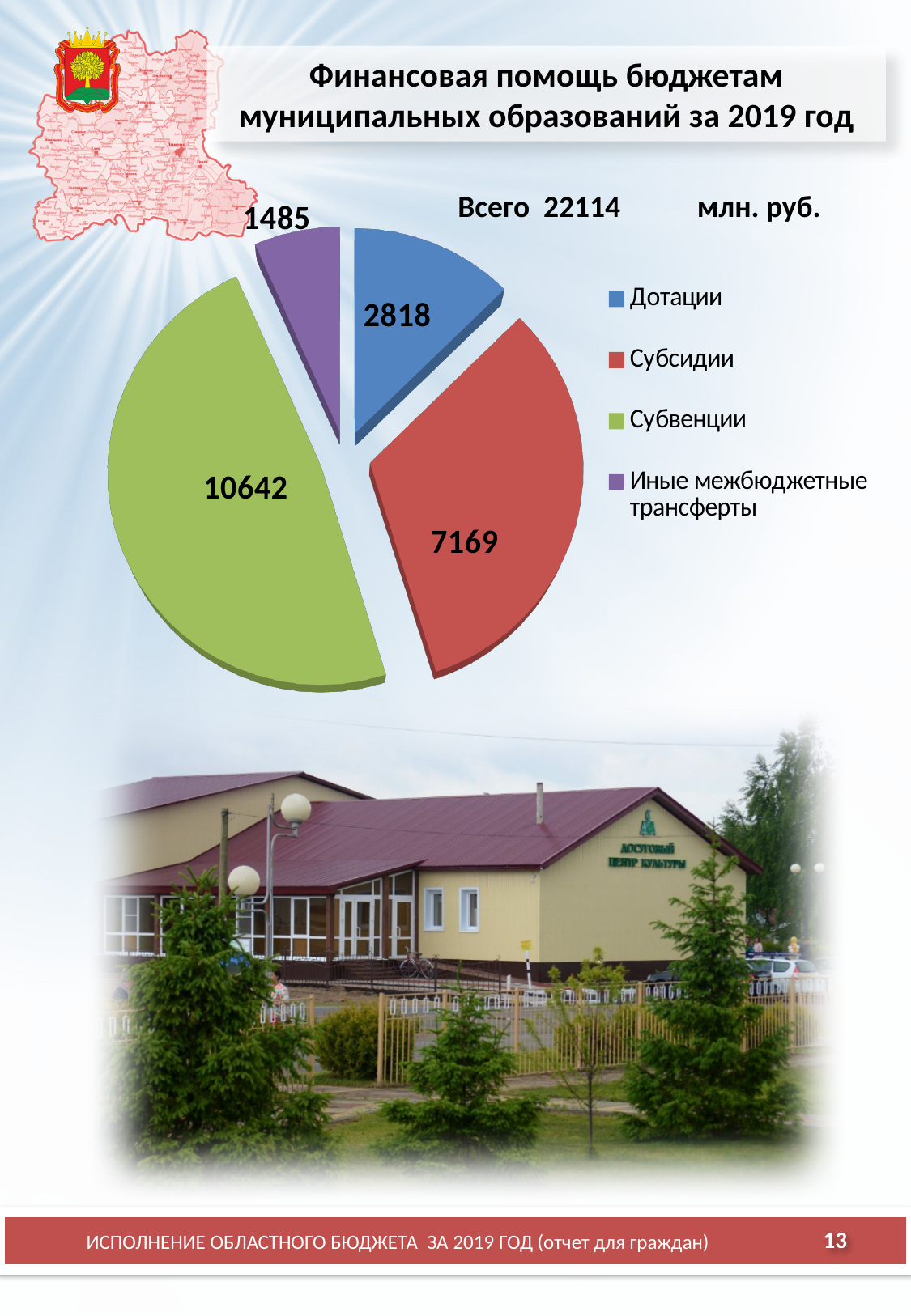
What is the value for Субвенции in the pie chart? 10642 Which category has the smallest slice in the pie chart? Иные межбюджетные трансферты Which is larger, the value for Субсидии or the value for Дотации? Субсидии What colour is the slice for Субсидии? Red What is the value for Иные межбюджетные трансферты in the pie chart? 1485 What is the value for Дотации in the pie chart? 2818 How many categories does the pie chart show? 4 What is the difference between the values for Субвенции and Субсидии? 3473 Which category has the largest slice in the pie chart? Субвенции What is the value for Субсидии in the pie chart? 7169 What is the total of all slices in the pie chart, in million rubles? 22114 What type of chart is shown on the slide? Pie chart